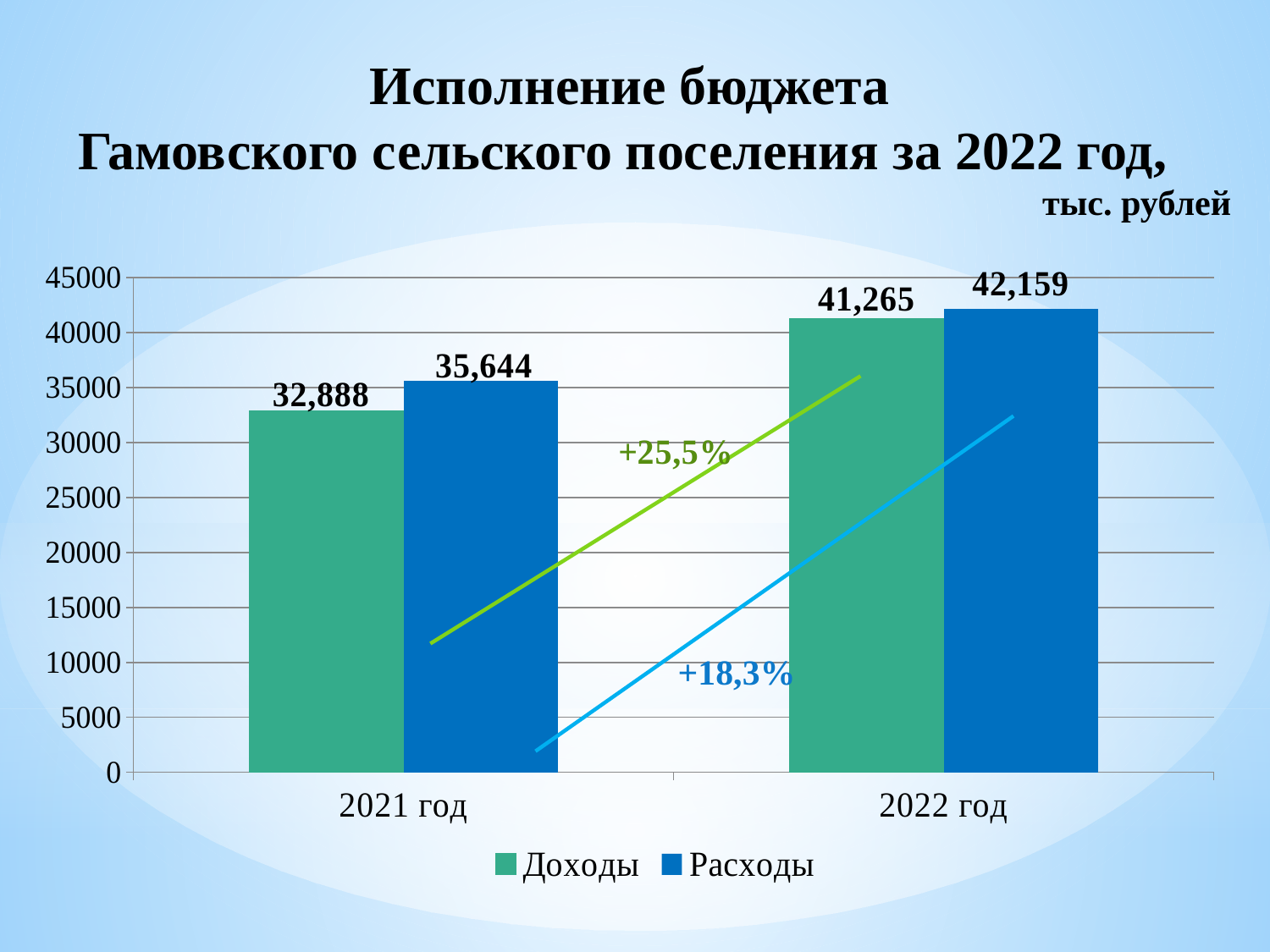
What is the value of Расходы for 2021 год? 35,644 Which bar has the lowest value on the chart? Доходы, 2021 год What is the value of Доходы for 2022 год? 41,265 What is the value of Расходы for 2022 год? 42,159 What kind of chart is shown on the slide? Bar chart How many series does the legend list? 2 What percentage growth is shown by the green arrow for Доходы? +25,5% By how much did Доходы increase from 2021 год to 2022 год? 8,377 Which bar has the highest value on the chart? Расходы, 2022 год What is the difference between Расходы and Доходы for 2021 год? 2,756 What is the value of Доходы for 2021 год? 32,888 Which is larger for 2022 год, Доходы or Расходы? Расходы